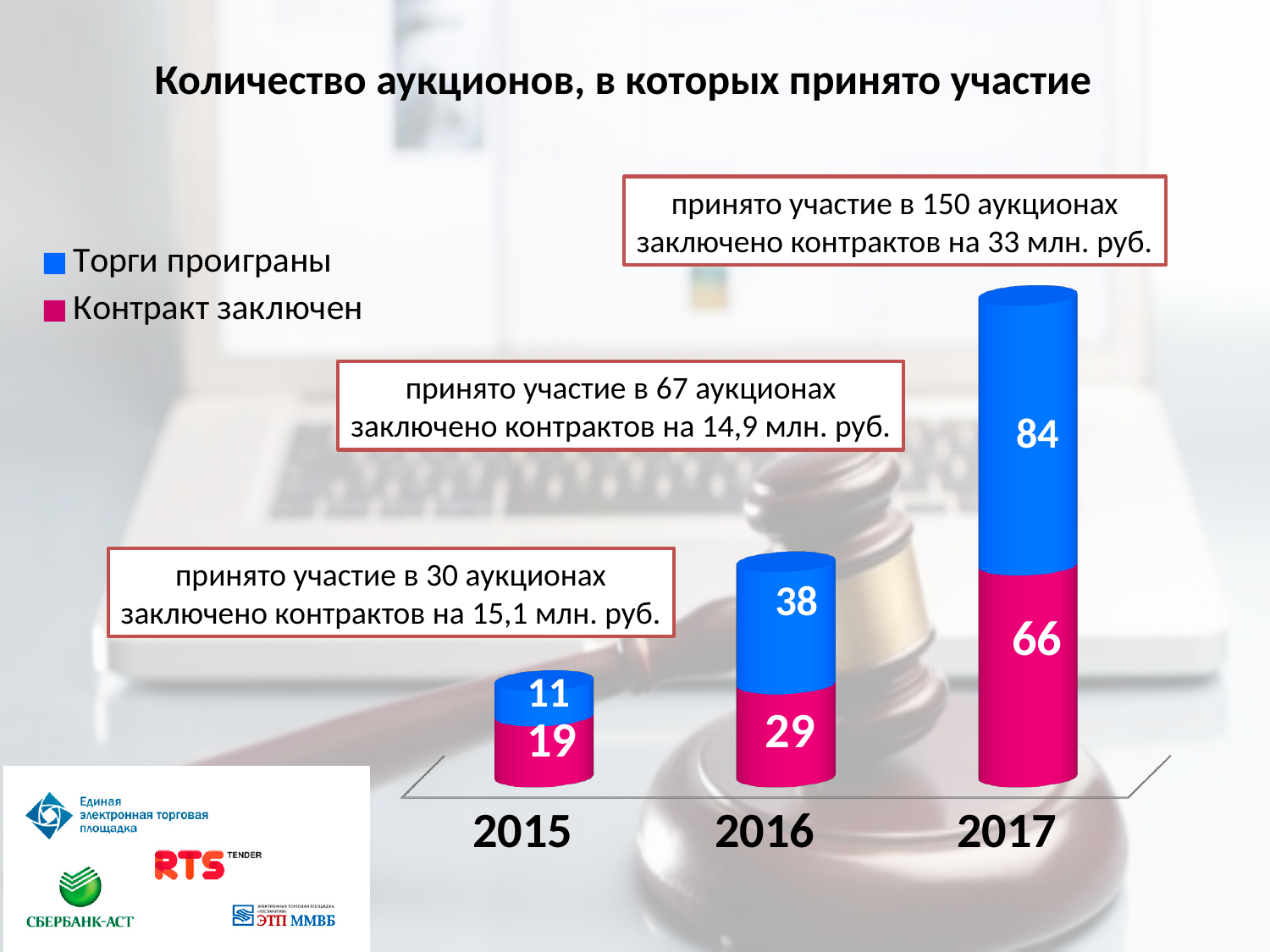
What is the value for 'Торги проиграны' in 2015? 11 Which is larger in 2015: 'Контракт заключен' or 'Торги проиграны'? Контракт заключен In which year is the 'Торги проиграны' value lowest? 2015 What is the value for 'Торги проиграны' in 2016? 38 How many series does the legend list? 2 What type of chart is shown on the slide? Stacked bar chart What is the total of the stacked bar for 2016? 67 What is the value for 'Контракт заключен' in 2017? 66 What is the title of the chart? Количество аукционов, в которых принято участие What is the difference between 'Торги проиграны' and 'Контракт заключен' in 2017? 18 How many years are shown on the x axis? 3 In which year is the 'Контракт заключен' value highest? 2017